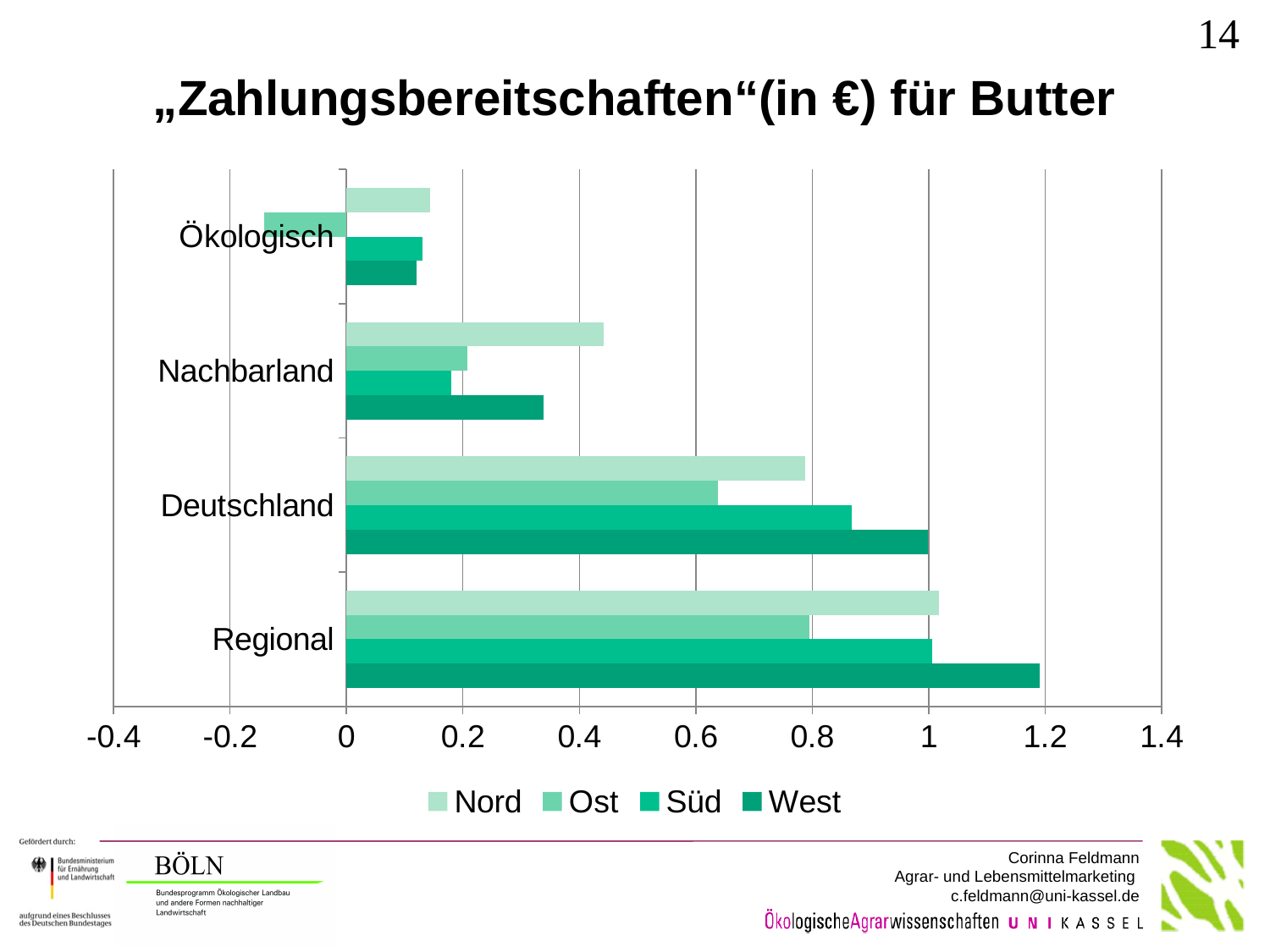
For the category Deutschland, which is larger: the value for Süd or the value for Ost? Süd Which series has the highest value for the category Regional? West What kind of chart is shown on the slide? bar chart Is the value for Ost in the category Deutschland greater or less than 0.8? less For the category Nachbarland, which is larger: the value for West or the value for Süd? West How many categories are shown on the vertical axis of the chart? 4 Which category has the highest value for the series West? Regional What is the title of the chart? „Zahlungsbereitschaften“(in €) für Butter Is the value for West in the category Regional greater or less than 1? greater Which series has the lowest value for the category Ökologisch? Ost Is the value for Ost in the category Ökologisch greater or less than 0? less How many series does the legend list? 4